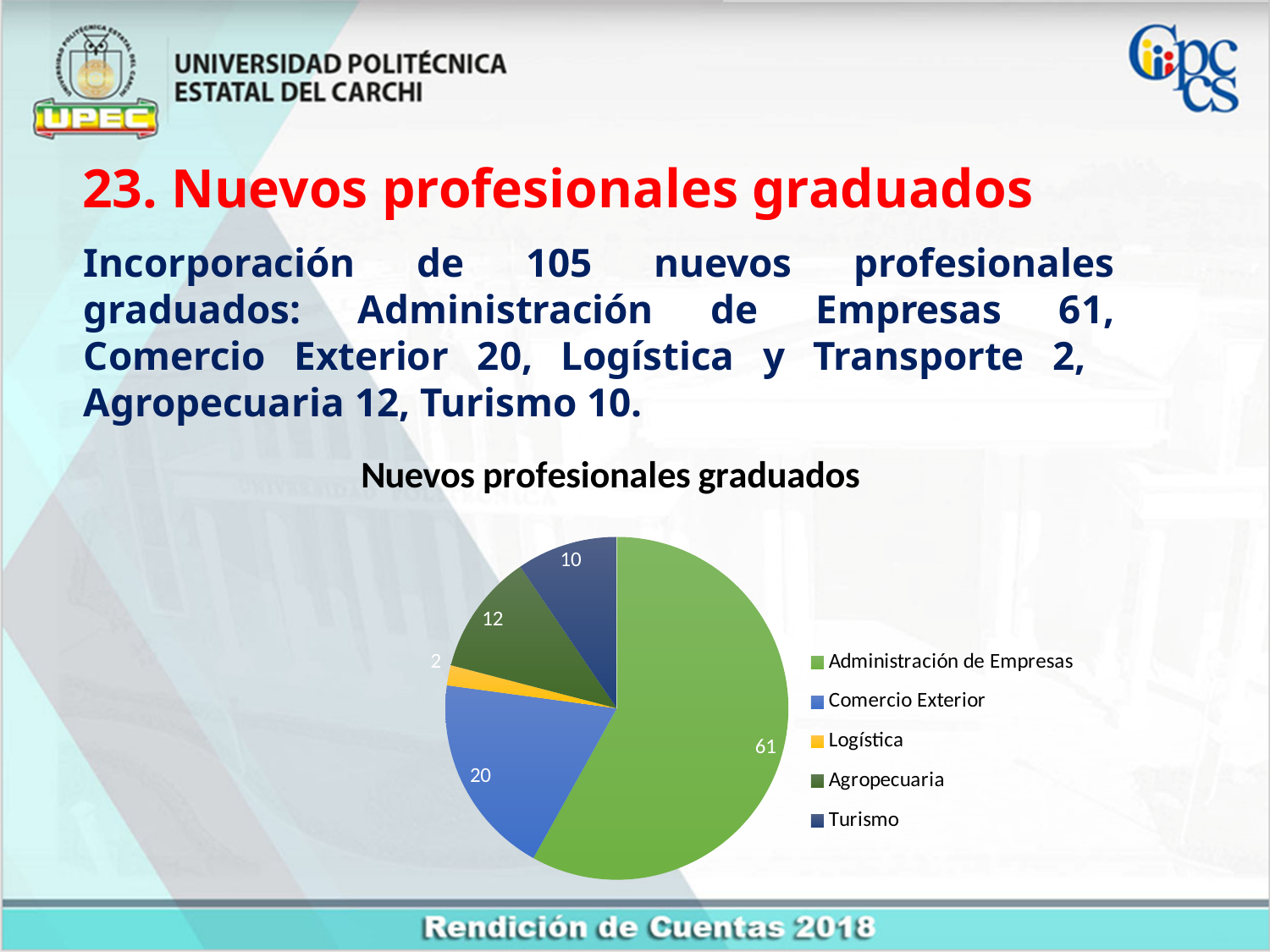
What is the title of the chart? Nuevos profesionales graduados What is the value for Agropecuaria? 12 What is the value for Comercio Exterior? 20 What is the value for Logística? 2 What is the value for Administración de Empresas? 61 Which is larger, the value for Agropecuaria or the value for Turismo? Agropecuaria How many entries does the legend list? 5 What type of chart is shown on the slide? pie chart How many slices does the pie chart have? 5 Which category has the smallest slice? Logística Which category has the largest slice? Administración de Empresas What is the difference between the values for Comercio Exterior and Turismo? 10